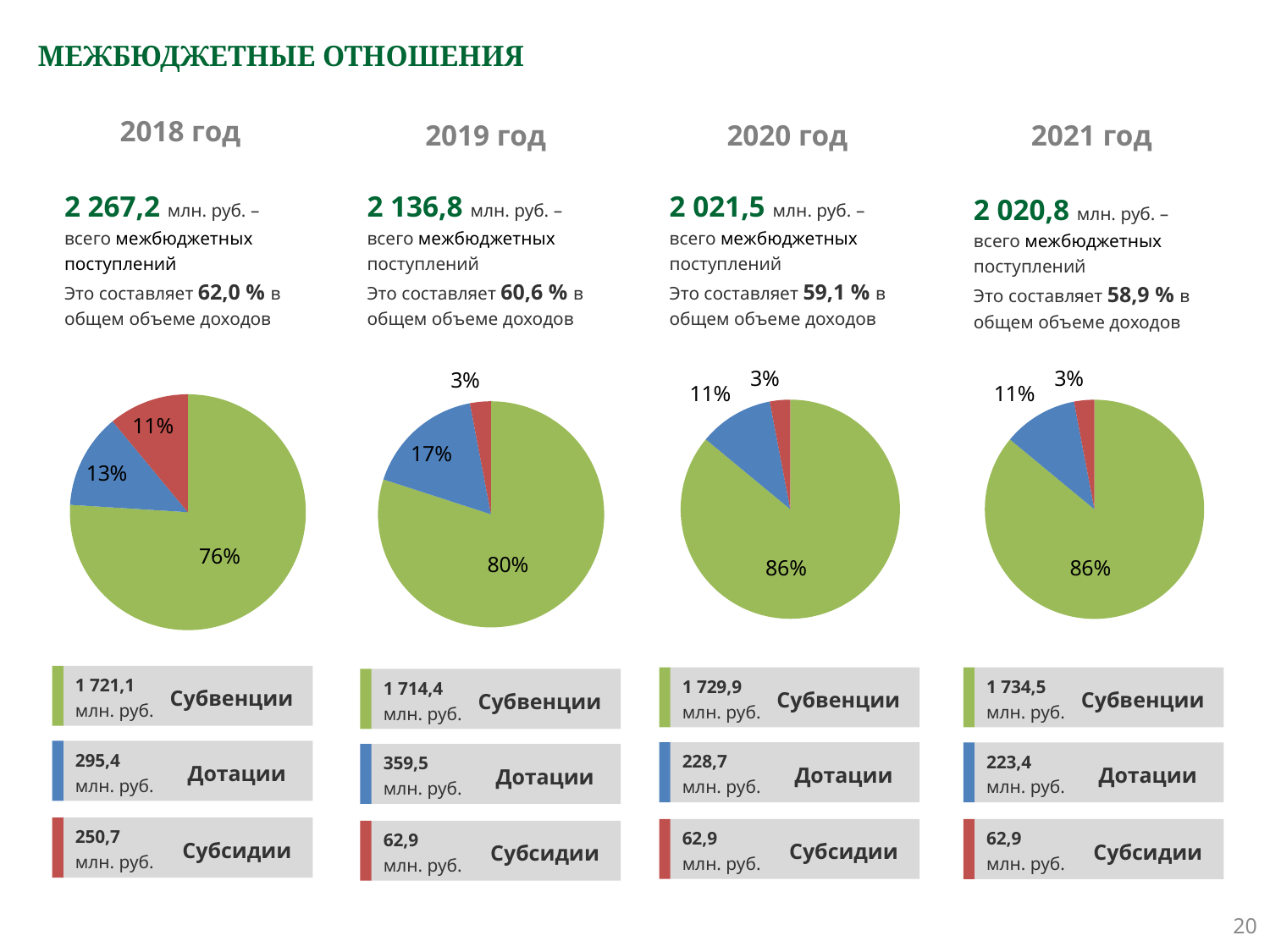
In the 2021 год pie chart, what percentage is shown for the red slice (Субсидии)? 3% In the 2018 год pie chart, what is the difference in percentage points between the Дотации slice and the Субсидии slice? 2 In the 2020 год pie chart, what percentage is shown for the green slice (Субвенции)? 86% How many slices does the 2020 год pie chart have? 3 Does the share of the Субвенции slice rise or fall from the 2018 год chart to the 2021 год chart? Rise In the 2019 год pie chart, which slice is larger: Дотации or Субсидии? Дотации In the 2018 год pie chart, which category has the smallest share? Субсидии What type of chart is used to show the 2021 год data? Pie chart What colour is used for the Субвенции slice in the pie charts? Green In the 2019 год pie chart, which category has the largest share? Субвенции In the 2019 год pie chart, what percentage is shown for the blue slice (Дотации)? 17% In the 2018 год pie chart, what share does the largest slice (Субвенции) have? 76%